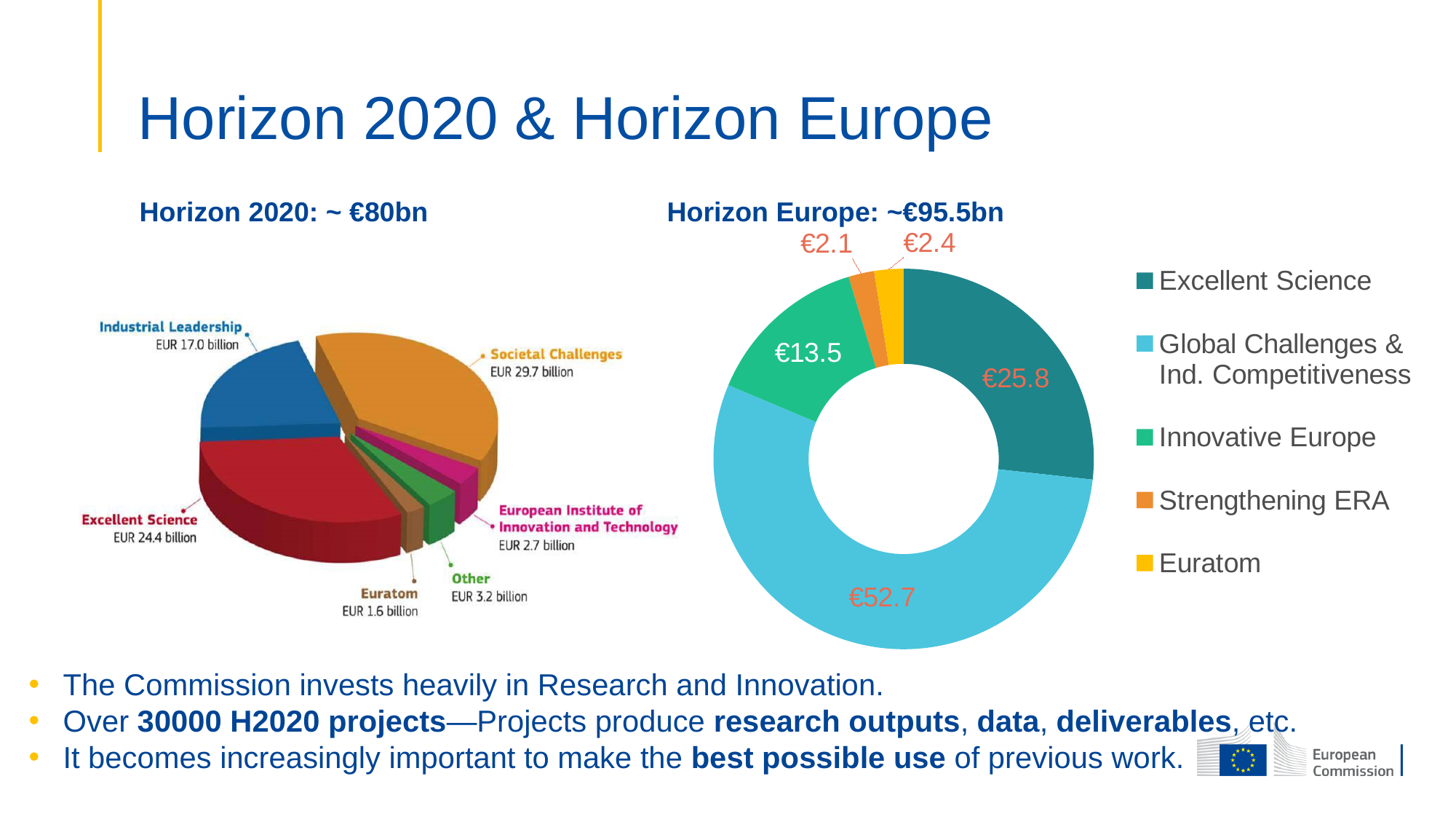
In the Horizon Europe chart, which category has the largest value? Global Challenges & Ind. Competitiveness In the Horizon 2020 chart, what is the difference between Excellent Science and Industrial Leadership? EUR 7.4 billion In the Horizon 2020 chart, which category has the smallest value? Euratom In the Horizon 2020 chart, what is the value for Industrial Leadership? EUR 17.0 billion In the Horizon Europe chart, which is larger, Strengthening ERA or Euratom? Euratom How many entries does the legend of the Horizon Europe chart list? 5 In the Horizon Europe chart, what is the value for Global Challenges & Ind. Competitiveness? €52.7 In the Horizon 2020 chart, what is the value for Societal Challenges? EUR 29.7 billion In the Horizon Europe chart, what is the value for Innovative Europe? €13.5 In the Horizon Europe chart, what is the difference between Excellent Science and Innovative Europe? €12.3 What kind of chart is the Horizon Europe chart? Doughnut chart In the Horizon 2020 chart, how many categories are shown? 6